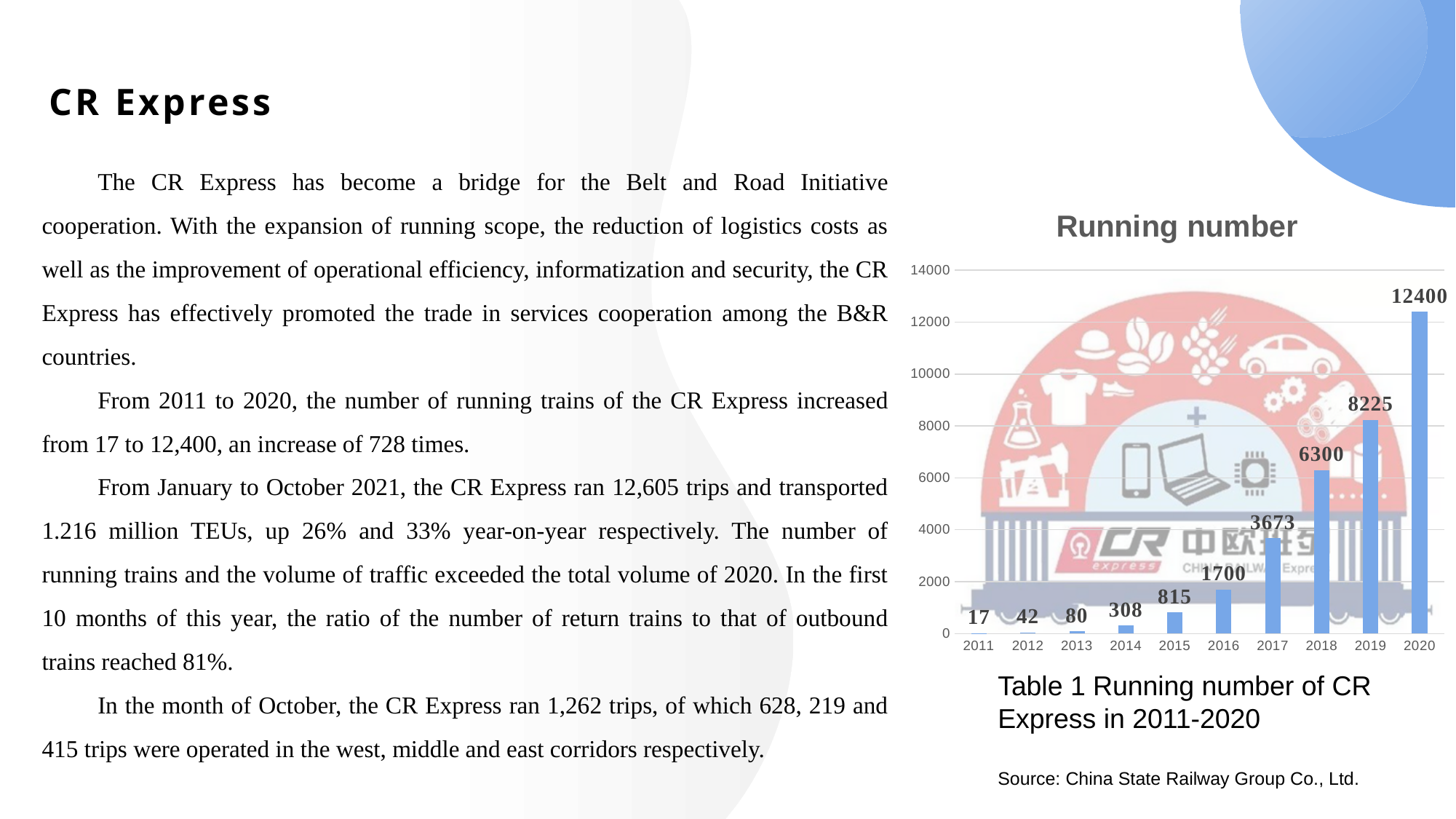
What is the difference between the running numbers for 2016 and 2015? 885 Which year has the highest running number? 2020 Is the running number for 2018 greater or less than 8000? less What is the running number for 2014? 308 How many years are shown on the x axis of the chart? 10 What is the difference between the running numbers for 2020 and 2019? 4175 Do the running numbers rise or fall from 2011 to 2020? rise What kind of chart is shown on the slide? bar chart What is the running number for 2019? 8225 Which year has the lowest running number? 2011 Which is larger, the running number for 2018 or for 2017? 2018 What is the running number for 2017? 3673